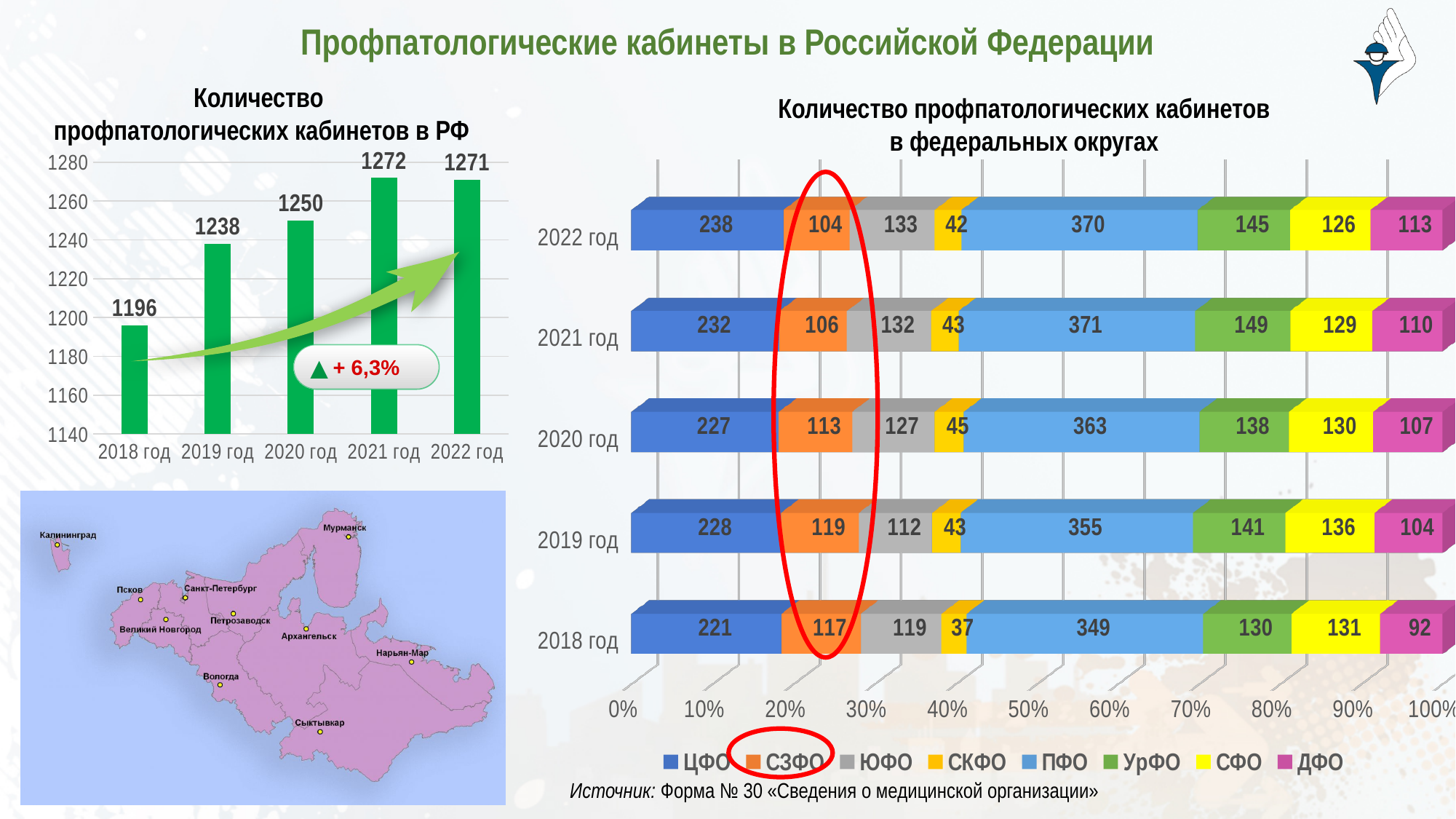
In the chart 'Количество профпатологических кабинетов в РФ', how many years are shown on the x axis? 5 In the chart 'Количество профпатологических кабинетов в федеральных округах', which series is circled in red in the legend? СЗФО In the chart 'Количество профпатологических кабинетов в РФ', which year has the highest value? 2021 год In the chart 'Количество профпатологических кабинетов в федеральных округах', what is the value for СЗФО in 2019 год? 119 In the chart 'Количество профпатологических кабинетов в РФ', which year has the lowest value? 2018 год In the chart 'Количество профпатологических кабинетов в РФ', what is the difference between the values for 2019 год and 2018 год? 42 What type of chart is 'Количество профпатологических кабинетов в РФ'? Bar chart In the chart 'Количество профпатологических кабинетов в федеральных округах', which is larger in 2022 год: ЦФО or ЮФО? ЦФО In the chart 'Количество профпатологических кабинетов в федеральных округах', how many series does the legend list? 8 In the chart 'Количество профпатологических кабинетов в федеральных округах', what is the value for ПФО in 2020 год? 363 In the chart 'Количество профпатологических кабинетов в федеральных округах', what is the total of the stacked bar for 2018 год? 1196 In the chart 'Количество профпатологических кабинетов в РФ', what is the value for 2020 год? 1250